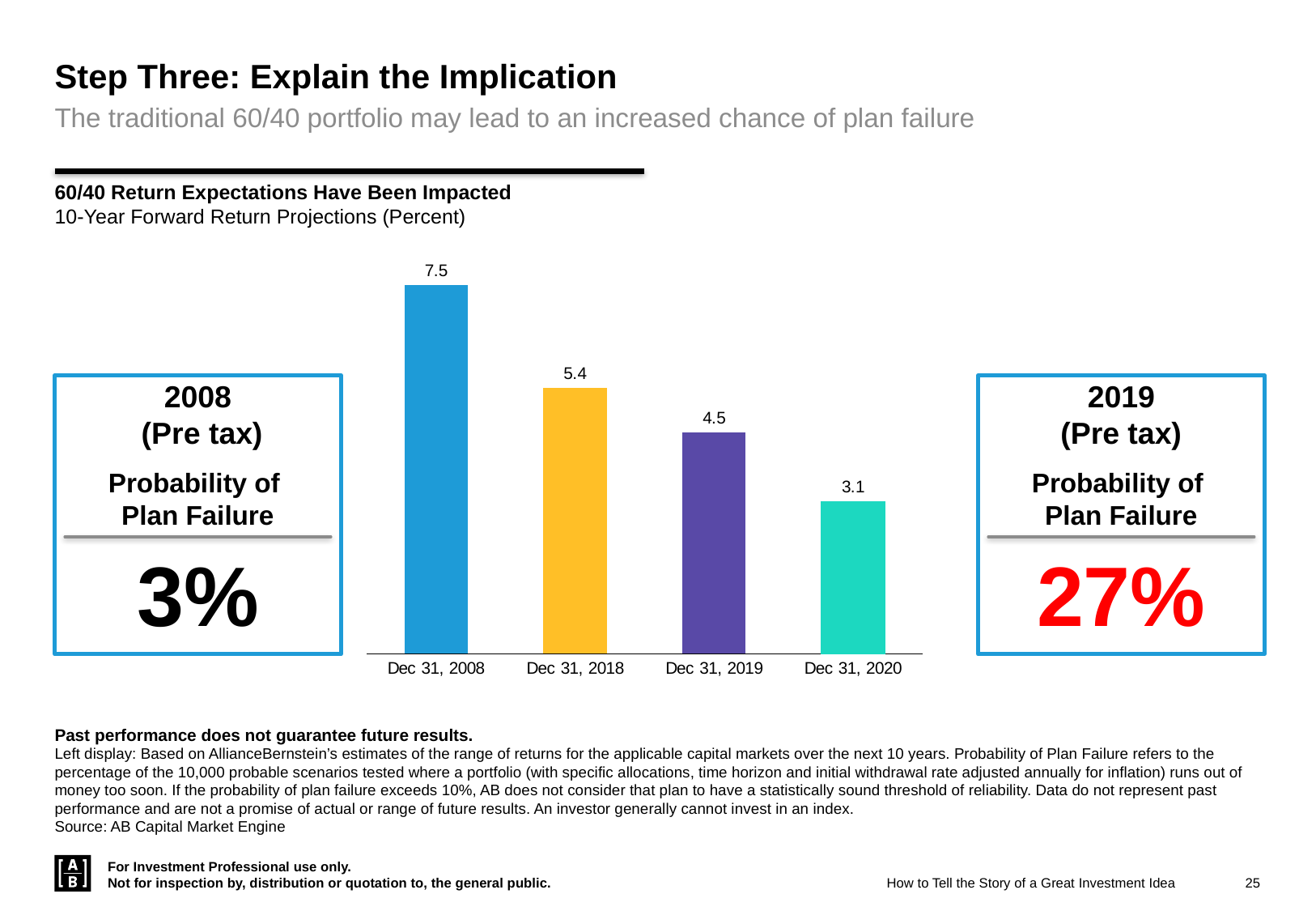
Which date has the lowest 10-year forward return projection? Dec 31, 2020 Which date has the highest 10-year forward return projection? Dec 31, 2008 What is the 10-year forward return projection for Dec 31, 2020? 3.1 What is the 10-year forward return projection for Dec 31, 2018? 5.4 How many dates are shown on the chart? 4 What is the 10-year forward return projection for Dec 31, 2008? 7.5 What is the title of the chart? 60/40 Return Expectations Have Been Impacted What is the 10-year forward return projection for Dec 31, 2019? 4.5 What kind of chart is shown on the slide? Bar chart Do the return projections rise or fall from Dec 31, 2008 to Dec 31, 2020? Fall What is the difference between the return projections for Dec 31, 2008 and Dec 31, 2020? 4.4 Which is larger, the return projection for Dec 31, 2018 or Dec 31, 2019? Dec 31, 2018